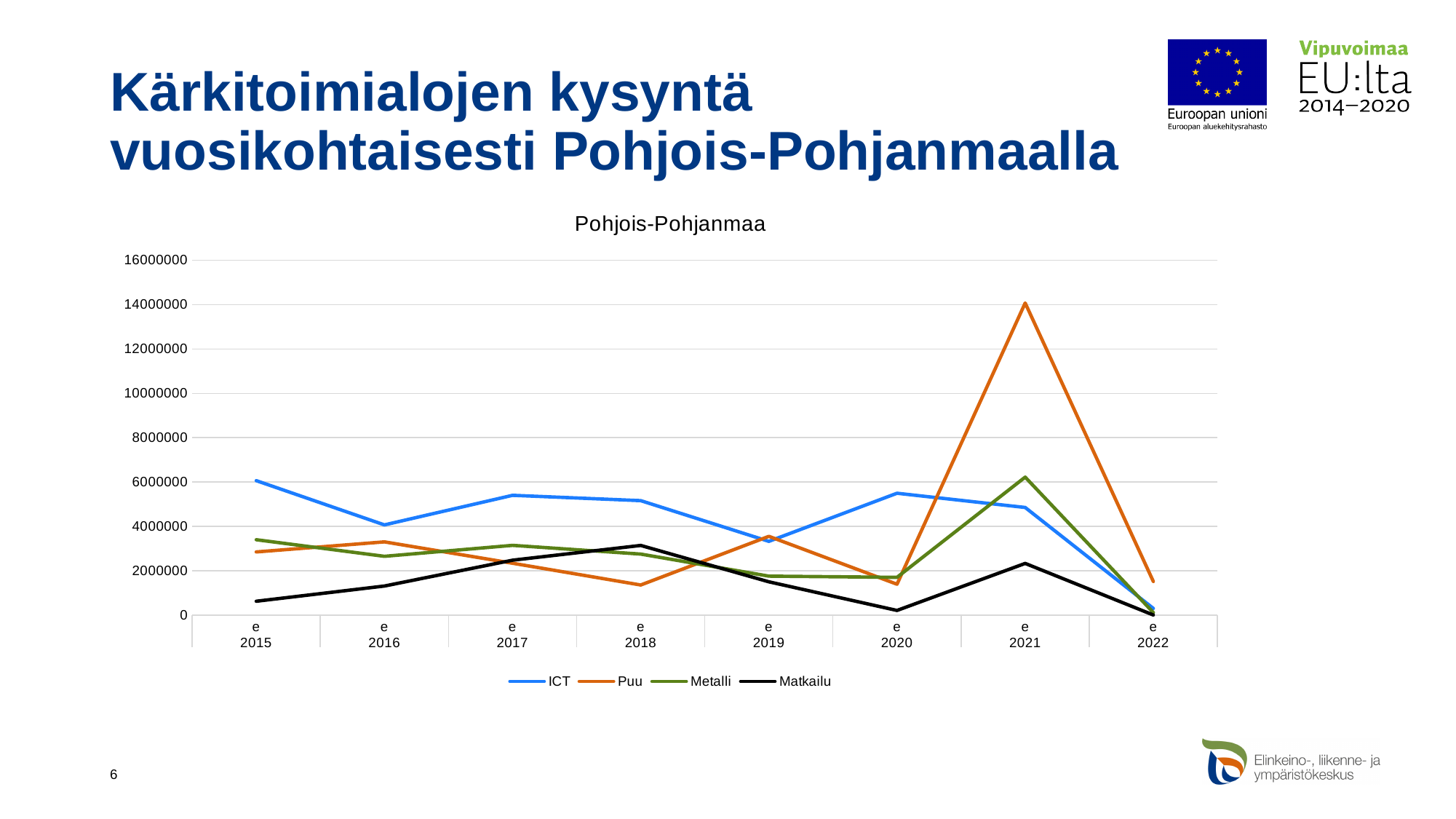
What colour is the Matkailu line? black Which series has the lowest value in 2015? Matkailu Does the Puu line rise or fall from 2020 to 2021? rise In 2015, which is larger, ICT or Matkailu? ICT How many series does the legend list? 4 Is the value for Matkailu in 2020 greater or less than 2000000? less Is the value for Puu in 2021 greater or less than 12000000? greater What is the title of the chart? Pohjois-Pohjanmaa How many years are shown on the x axis? 8 Which series has the highest value in 2021? Puu What kind of chart is shown on the slide? line chart Is the value for ICT in 2015 greater or less than 4000000? greater